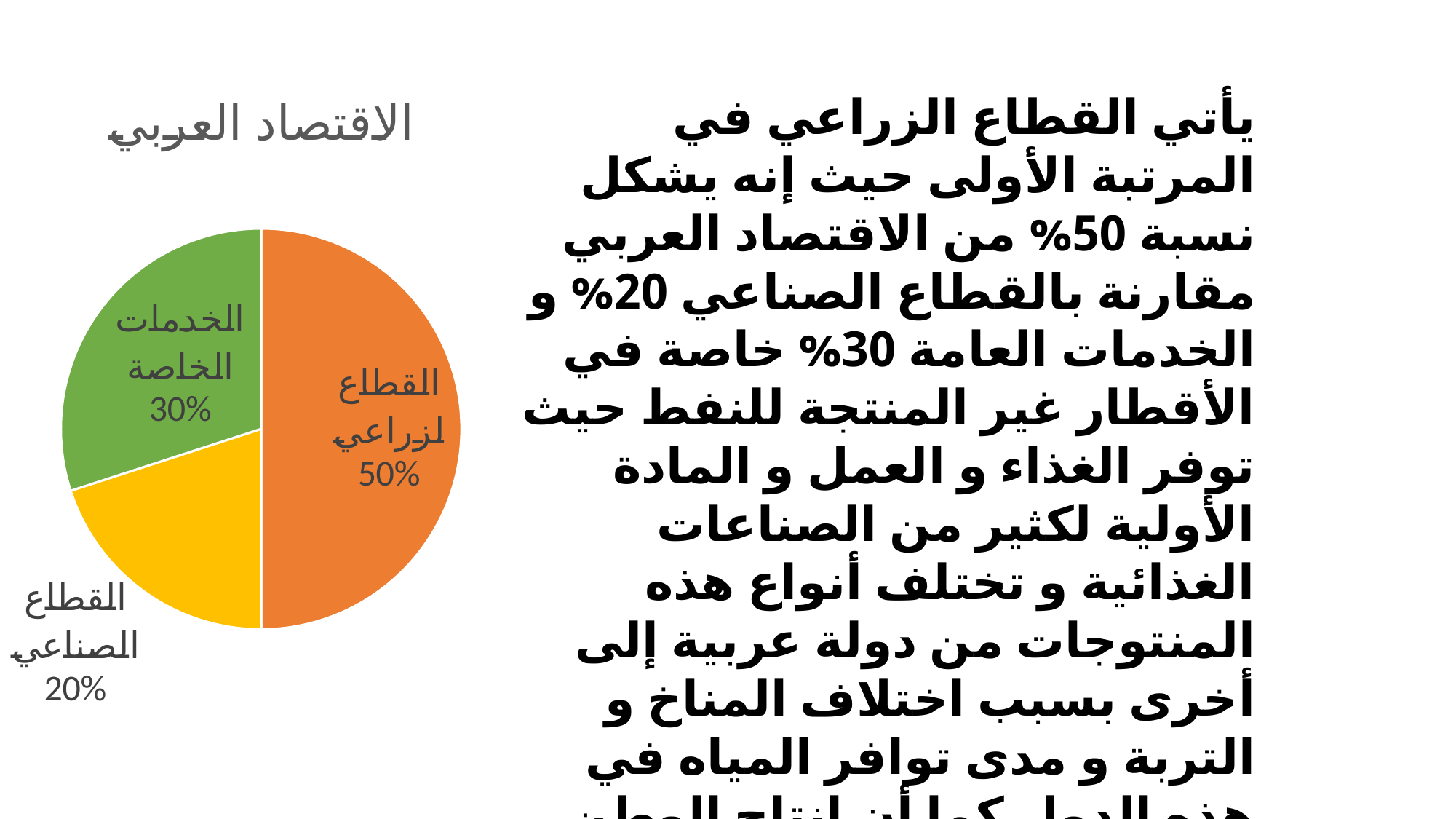
What kind of chart is shown on the slide? Pie chart What share of the pie does الخدمات الخاصة (private services) hold? 30% What is the difference in percentage points between القطاع الزراعي and القطاع الصناعي? 30 Which slice of the pie chart is the smallest? القطاع الصناعي How many slices does the pie chart have? 3 Which slice of the pie chart is the largest? القطاع الزراعي What share of the pie does القطاع الصناعي (the industrial sector) hold? 20% What is the difference in percentage points between الخدمات الخاصة and القطاع الصناعي? 10 What is the title of the pie chart? الاقتصاد العربي What share of the pie does القطاع الزراعي (the agricultural sector) hold? 50% What colour is the slice for القطاع الزراعي? Orange Which is larger, the share for الخدمات الخاصة or the share for القطاع الصناعي? الخدمات الخاصة